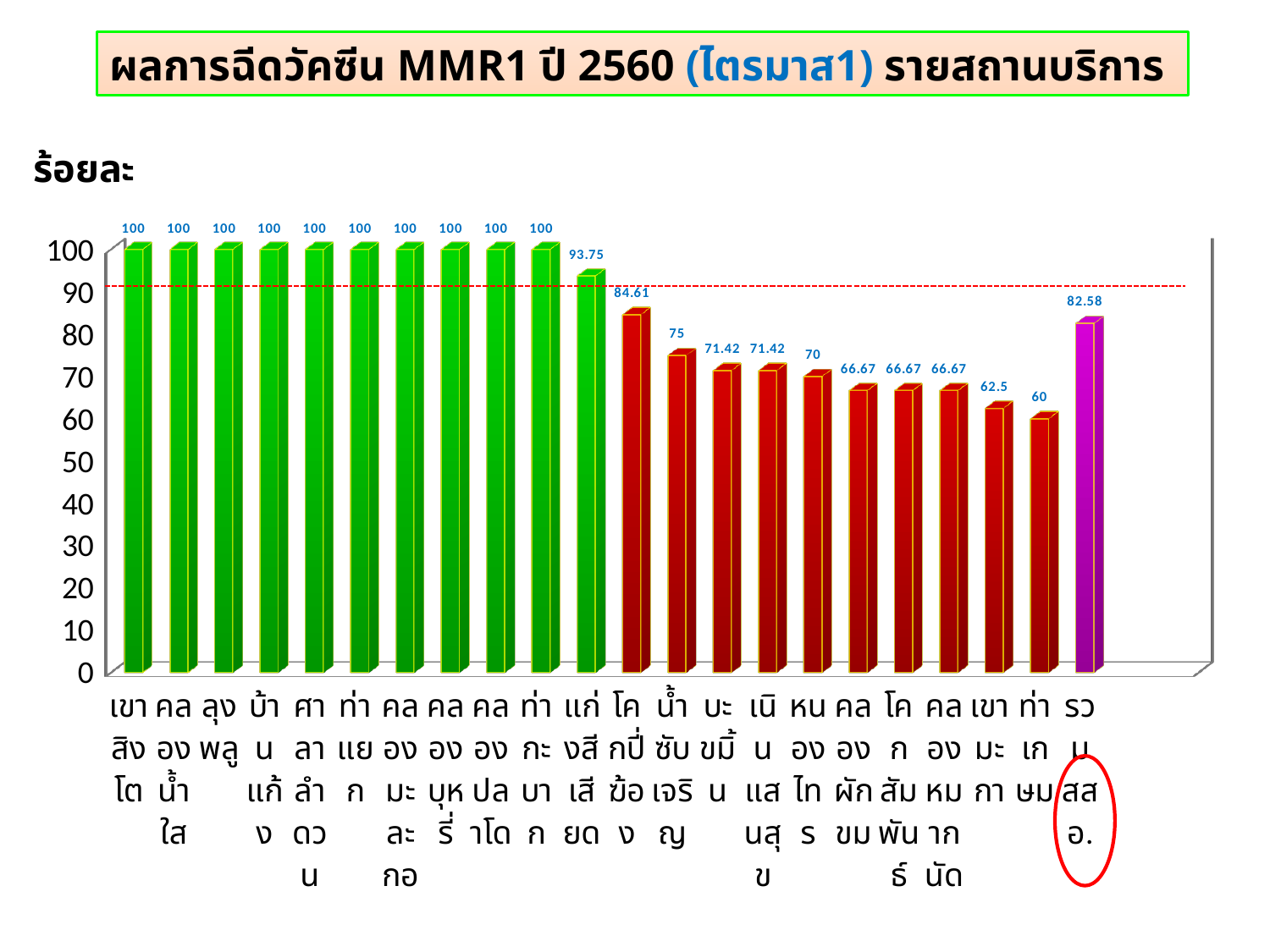
What is the label on the y axis of the chart? ร้อยละ What is the value for เขามะกา? 62.5 Which is larger, the value for น้ำซับเจริญ or the value for หนองไทร? น้ำซับเจริญ What is the value for รวม สสอ. (the last bar)? 82.58 What type of chart is shown on the slide? bar chart What is the value for ท่าเกษม? 60 Which facility has the lowest value on the chart? ท่าเกษม What is the value for โคกปี่ฆ้อง? 84.61 What is the value for แก่งสีเสียด? 93.75 What is the difference between the values for แก่งสีเสียด and โคกปี่ฆ้อง? 9.14 How many bars have a value of 100? 10 How many bars are plotted on the chart? 22